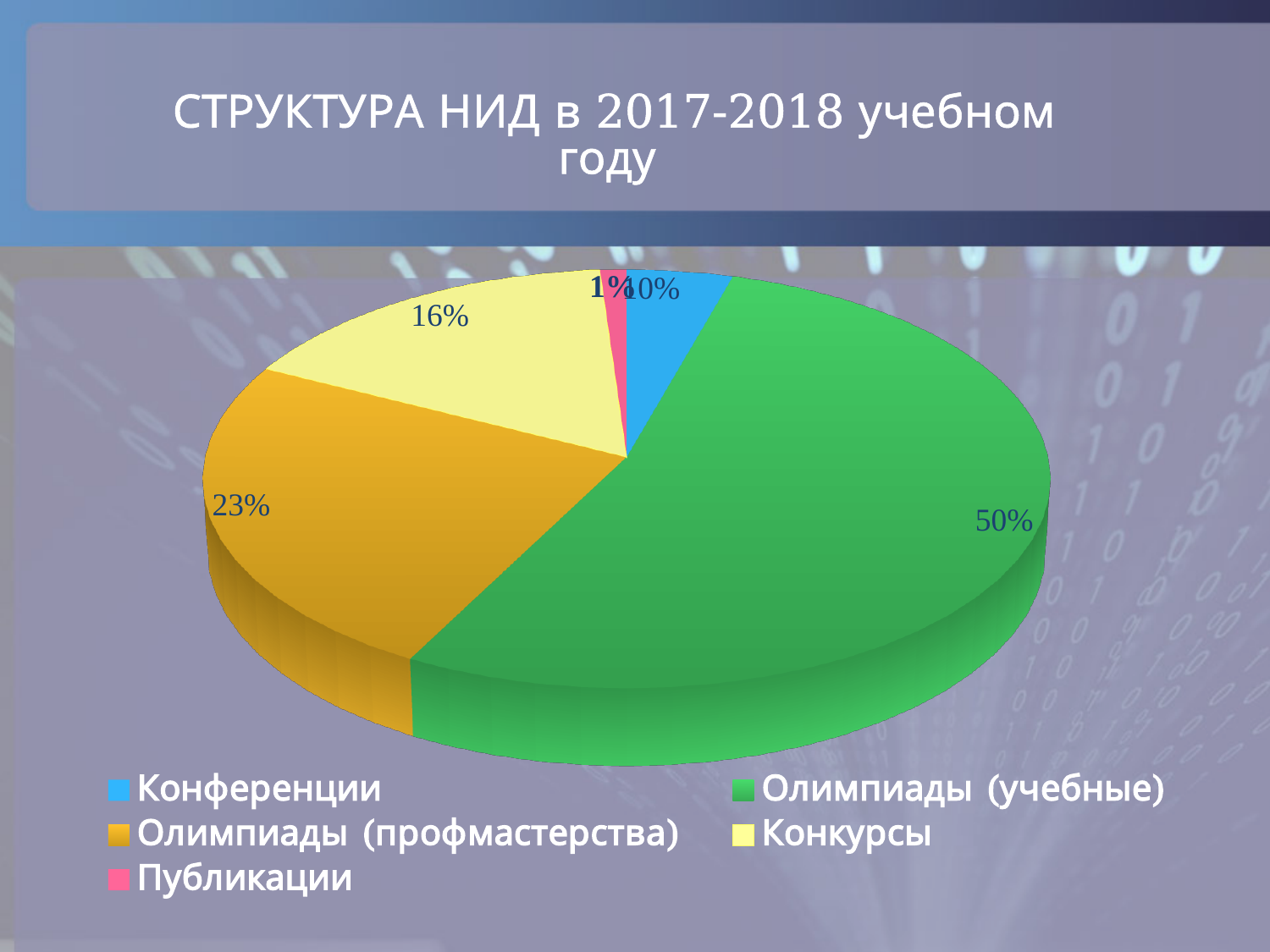
How many categories does the pie chart show? 5 Which category has the largest slice of the pie? Олимпиады (учебные) Which is larger, the share for Конференции or the share for Конкурсы? Конкурсы What share of the pie does Олимпиады (профмастерства) have? 23% What is the difference in percentage points between Олимпиады (профмастерства) and Конкурсы? 7 Which category has the smallest slice of the pie? Публикации What share of the pie does Олимпиады (учебные) have? 50% What share of the pie does Конференции have? 10% What is the title of the chart on the slide? СТРУКТУРА НИД в 2017-2018 учебном году What kind of chart is shown on the slide? pie chart